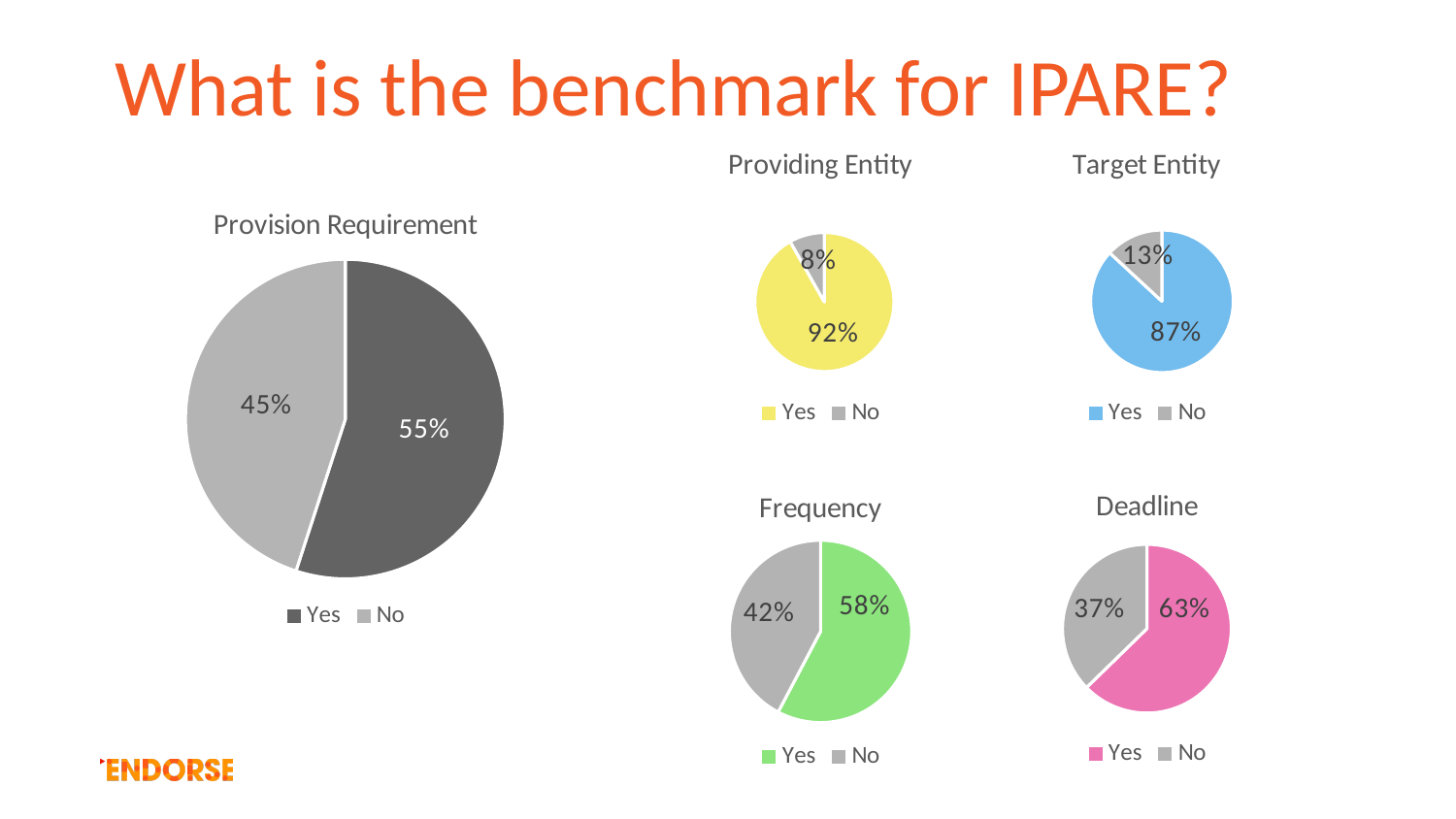
In the Provision Requirement chart, what percentage is shown for No? 45% In the Frequency chart, what percentage is shown for Yes? 58% In the Providing Entity chart, what percentage is shown for Yes? 92% How many entries does the legend of the Provision Requirement chart list? 2 In the Deadline chart, what is the difference between the Yes and No percentages? 26% In the Target Entity chart, what colour is the Yes slice? Blue In the Target Entity chart, what percentage is shown for No? 13% In the Providing Entity chart, which slice is larger, Yes or No? Yes In the Provision Requirement chart, what percentage is shown for Yes? 55% What kind of chart is the Frequency chart? Pie chart In the Deadline chart, what percentage is shown for No? 37% How many slices does the Target Entity chart have? 2